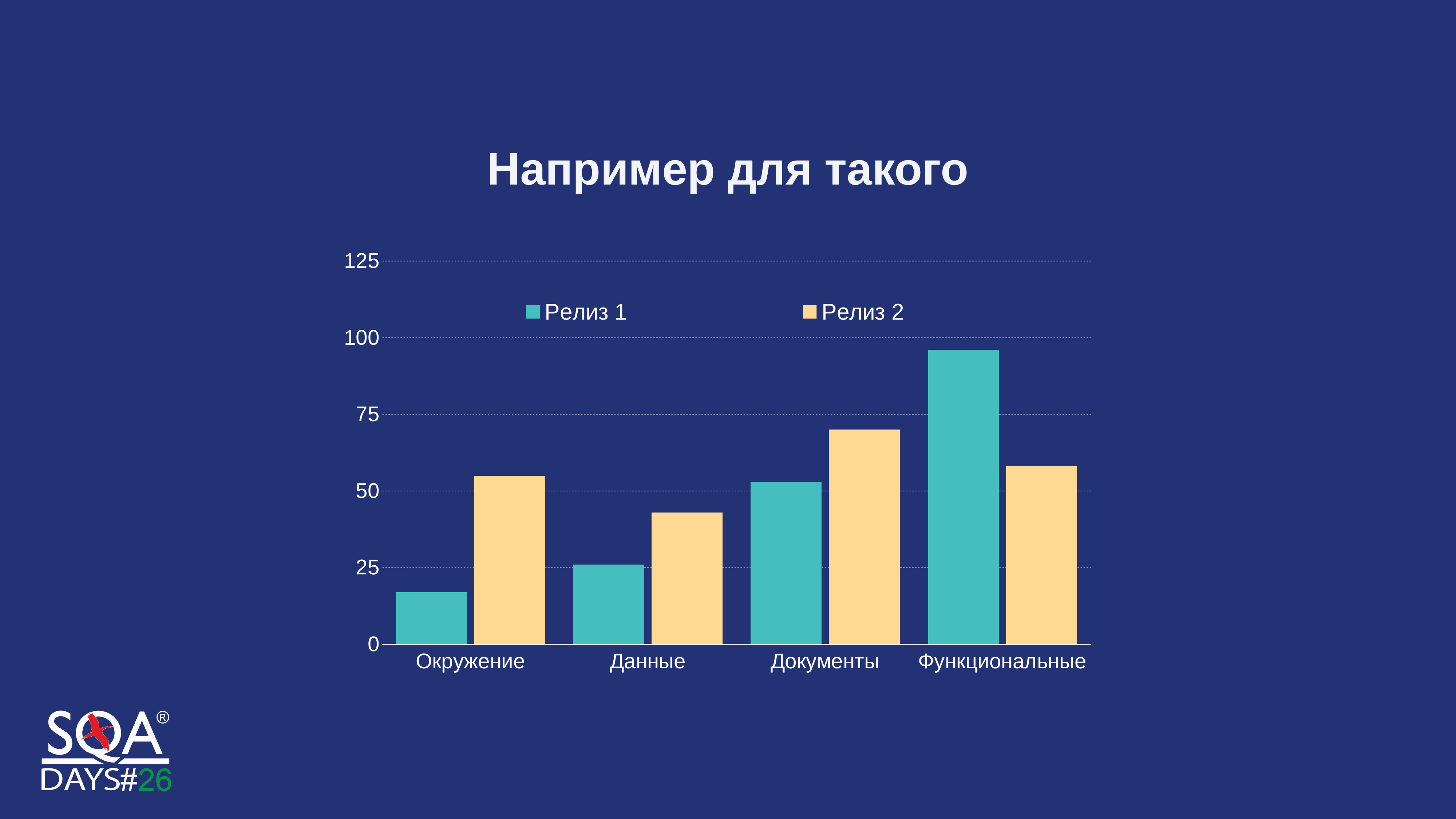
For Функциональные, which series has the larger value, Релиз 1 or Релиз 2? Релиз 1 How many series does the legend list? 2 Is the value for Релиз 1 in Функциональные greater or less than 75? greater What kind of chart is shown on the slide? bar chart How many categories are shown on the x axis? 4 Which category has the highest value for Релиз 1? Функциональные Which category has the lowest value for Релиз 2? Данные Do the Релиз 1 values rise or fall from Окружение to Функциональные along the x axis? rise For Окружение, which series has the larger value, Релиз 1 or Релиз 2? Релиз 2 Which category has the lowest value for Релиз 1? Окружение What is the title of the slide? Например для такого Which category has the highest value for Релиз 2? Документы